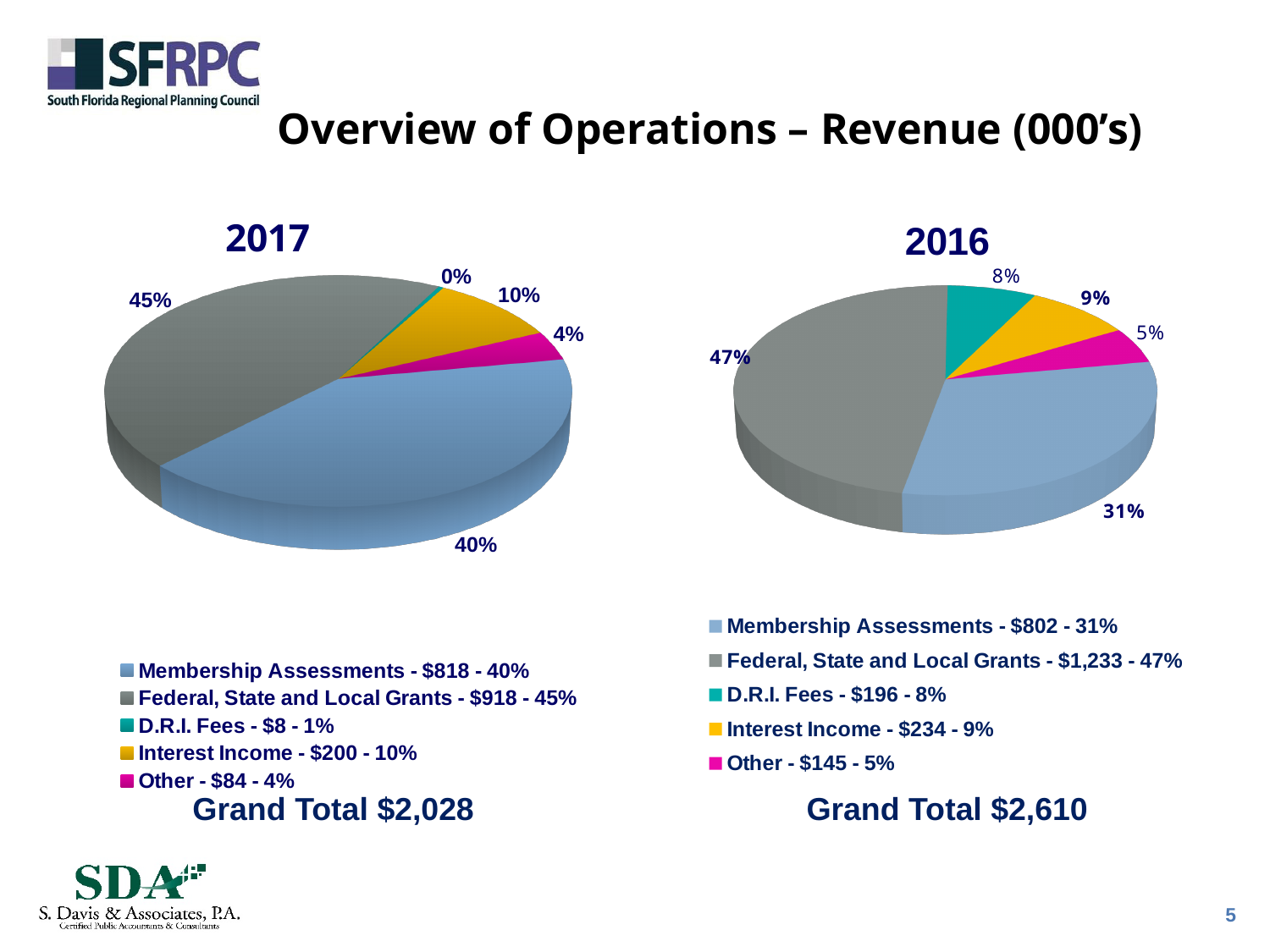
In the 2016 chart, what is the value for D.R.I. Fees according to the legend? $196 What type of chart is used for the 2017 revenue breakdown? Pie chart In the 2016 chart, which is larger: Interest Income or Other? Interest Income In the 2017 chart, what share of revenue comes from Federal, State and Local Grants? 45% In the 2016 chart, what share of revenue comes from Membership Assessments? 31% In the 2016 chart, which category has the largest share of revenue? Federal, State and Local Grants In the 2017 chart, what is the difference between Federal, State and Local Grants and Membership Assessments in dollars? $100 What is the Grand Total shown under the 2016 chart? $2,610 How many categories does the 2016 chart's legend list? 5 In the 2017 chart, what is the value for Interest Income according to the legend? $200 In the 2017 chart, which category has the smallest share of revenue? D.R.I. Fees In the 2016 chart, what colour represents Other? Magenta